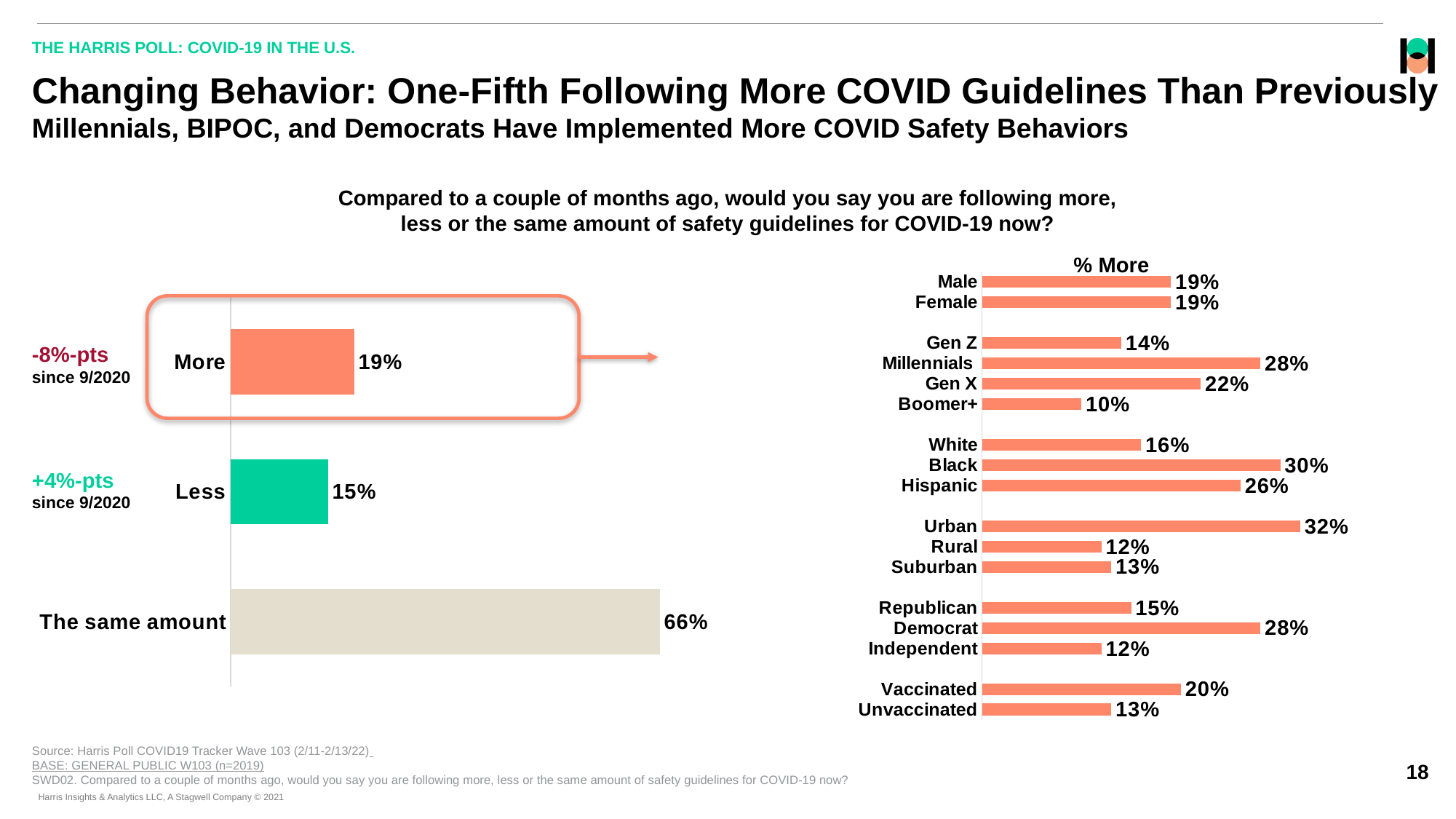
In the left chart, what percentage say they are following less safety guidelines? 15% In the '% More' chart, which group has the lowest value? Boomer+ In the left chart, which response has the highest percentage? The same amount What type of chart is the '% More' chart? Bar chart In the left chart, what is the difference between the 'More' and 'Less' percentages? 4% In the '% More' chart, which is larger, Black or Hispanic? Black In the '% More' chart, what is the difference between Democrat and Republican? 13% In the left chart, what percentage of respondents say they are following the same amount of safety guidelines? 66% In the '% More' chart, what is the value for Millennials? 28% In the '% More' chart, what is the value for Unvaccinated? 13% In the '% More' chart, which group has the highest value? Urban In the left chart, how many response categories are shown? 3